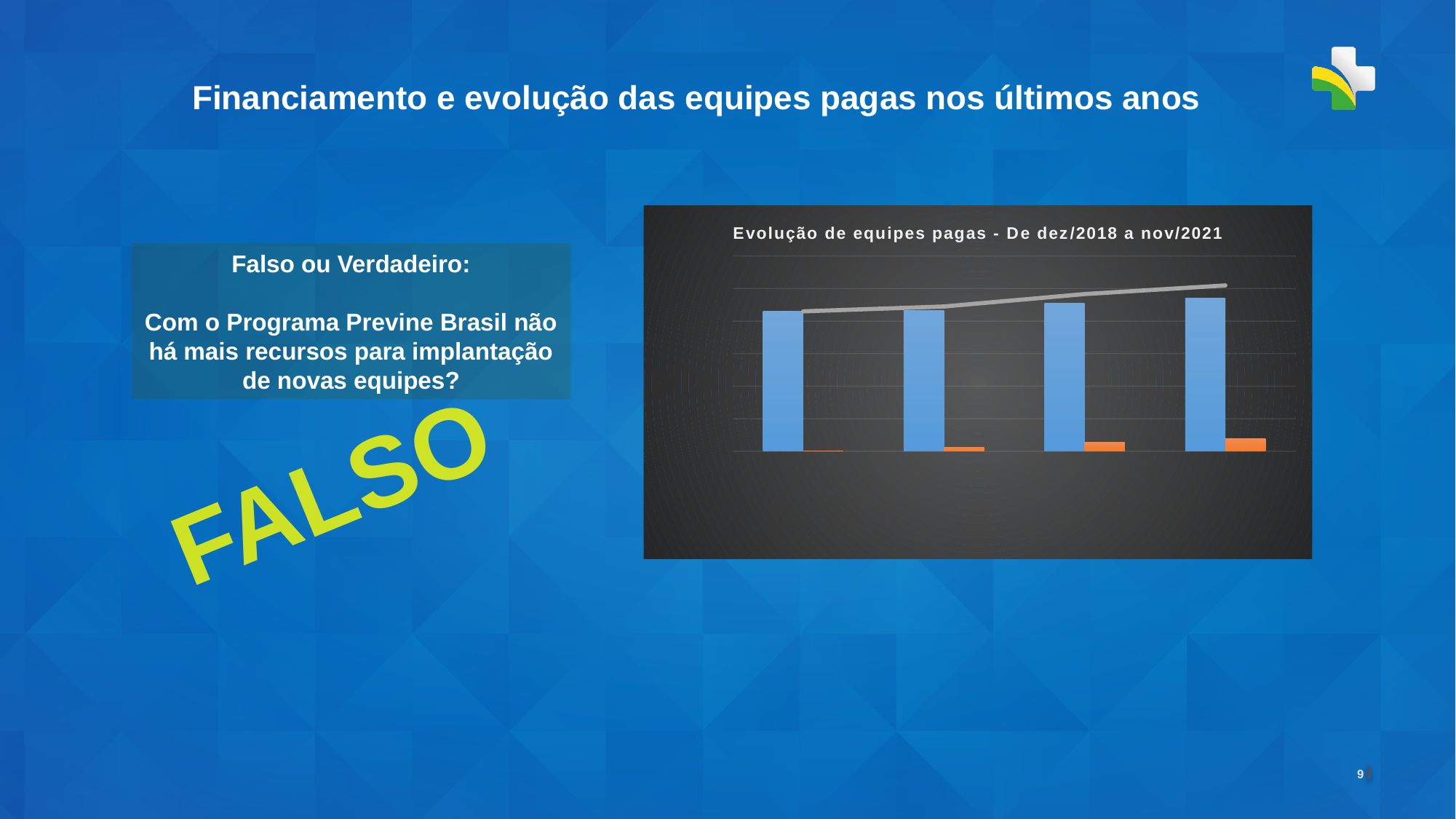
What is the title of the chart on the slide? Evolução de equipes pagas - De dez/2018 a nov/2021 Do the orange bars rise or fall from left to right across the chart? rise Which colour are the shorter bars next to the blue bars in the chart? orange Does the grey line in the chart rise or fall from left to right? rise Which blue bar is taller: the leftmost or the rightmost? the rightmost How many blue bars are plotted in the chart? 4 What kind of chart is shown on the slide? bar chart with a line Do the blue bars rise or fall from left to right across the chart? rise